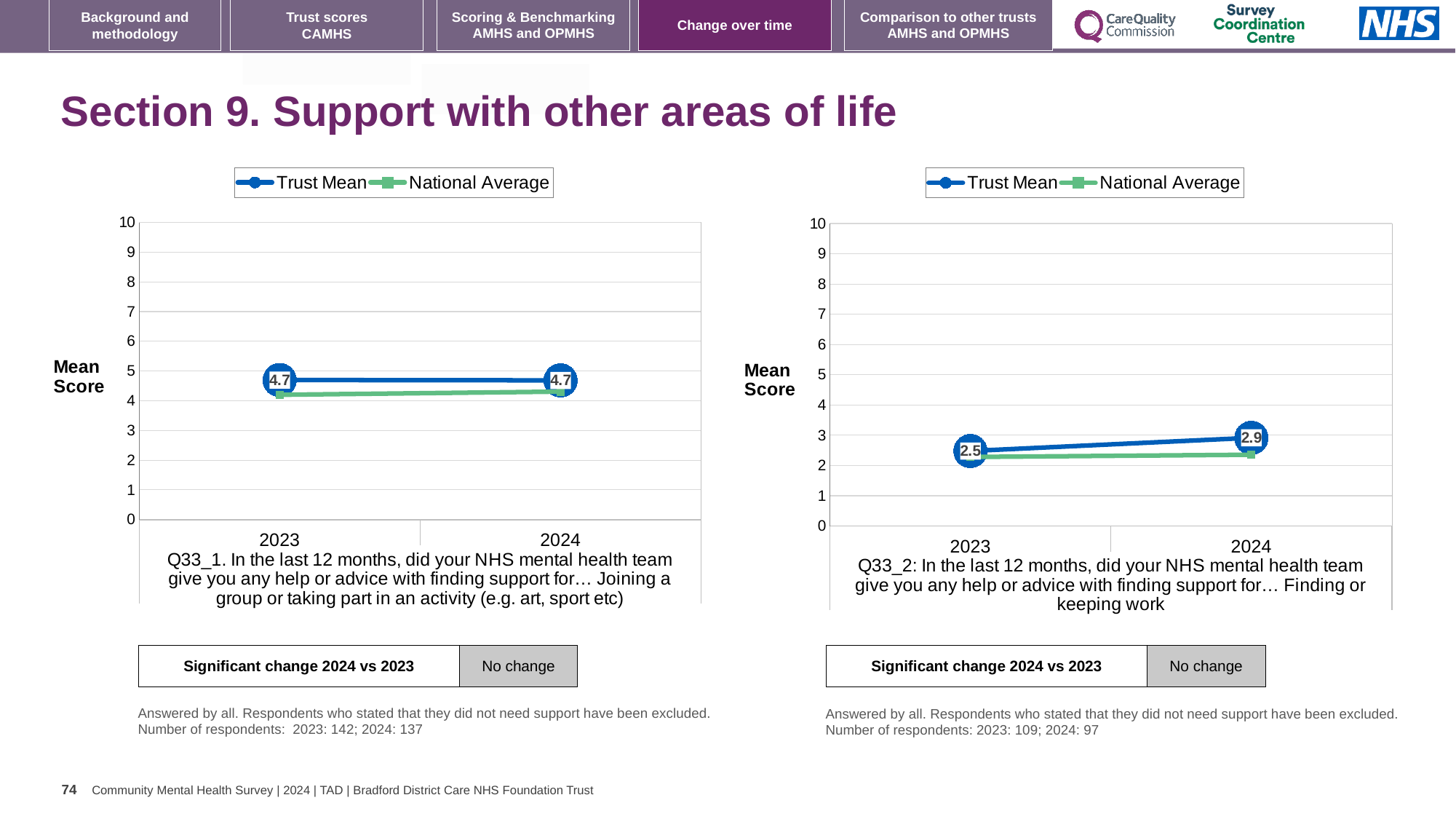
In the right chart (Q33_2), does the Trust Mean rise or fall from 2023 to 2024? rise In the right chart (Q33_2), which year has the higher Trust Mean, 2023 or 2024? 2024 In the right chart (Q33_2), what is the Trust Mean for 2023? 2.5 In the left chart (Q33_1), what is the Trust Mean for 2023? 4.7 In the right chart (Q33_2), is the National Average for 2024 greater or less than 3? less In the right chart (Q33_2), what is the Trust Mean for 2024? 2.9 In the left chart (Q33_1), what is the Trust Mean for 2024? 4.7 How many series does the legend of the left chart (Q33_1) list? 2 What type of chart is the right chart (Q33_2)? line chart How many years are plotted on the x axis of the left chart (Q33_1)? 2 In the right chart (Q33_2), by how much did the Trust Mean change from 2023 to 2024? 0.4 In the left chart (Q33_1), is the National Average for 2023 greater or less than 5? less